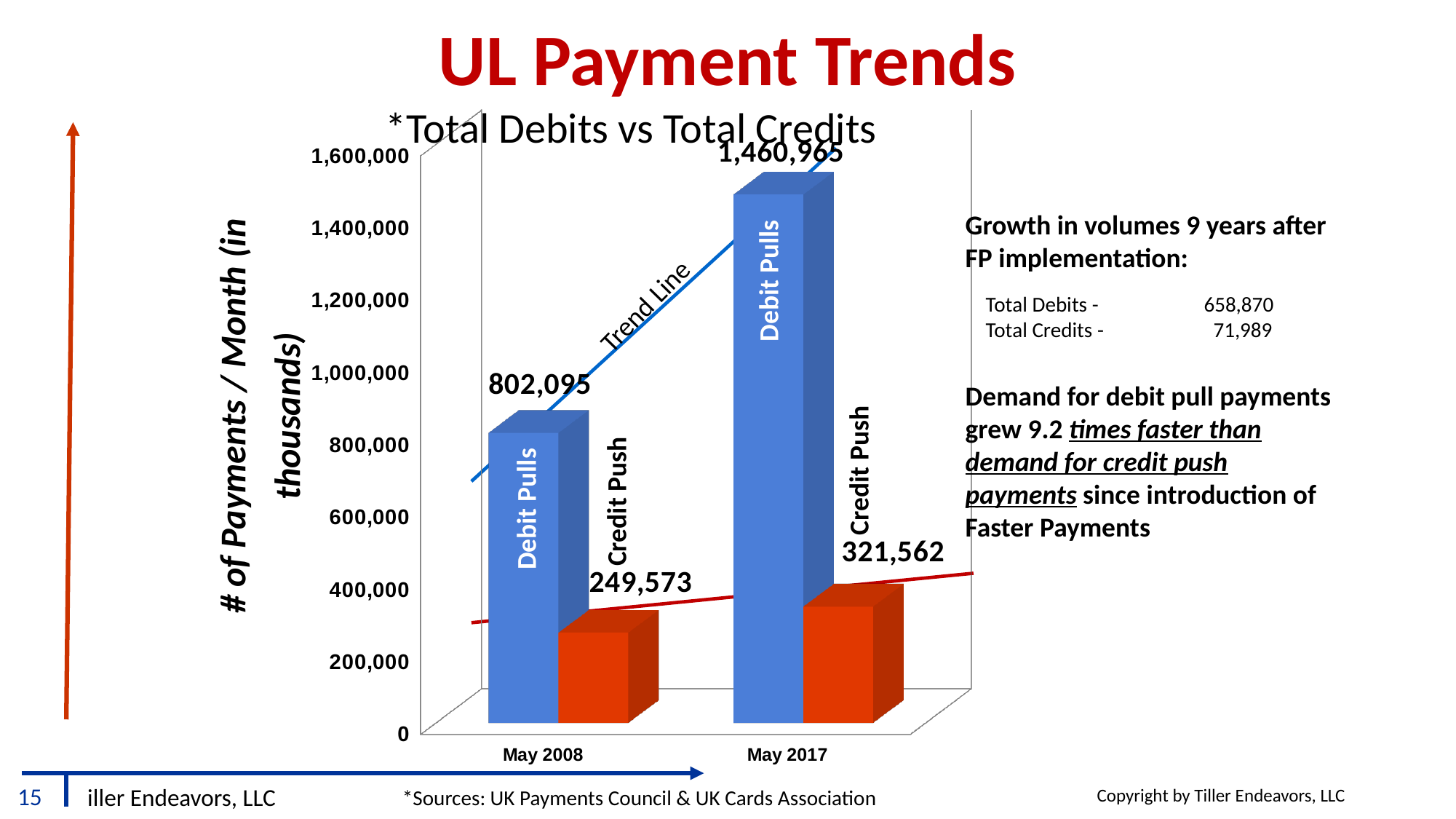
Which bar has the lowest value on the chart? Credit Push, May 2008 What is the value of Credit Push for May 2017? 321,562 What type of chart is shown on the slide? Bar chart By how much did Credit Push increase from May 2008 to May 2017? 71,989 What is the value of Debit Pulls for May 2017? 1,460,965 What is the value of Credit Push for May 2008? 249,573 What is the value of Debit Pulls for May 2008? 802,095 Which bar has the highest value on the chart? Debit Pulls, May 2017 Is the value of Debit Pulls for May 2017 greater or less than 1,400,000? greater Which is larger in May 2008, Debit Pulls or Credit Push? Debit Pulls How many time periods are shown on the x axis? 2 By how much did Debit Pulls increase from May 2008 to May 2017? 658,870